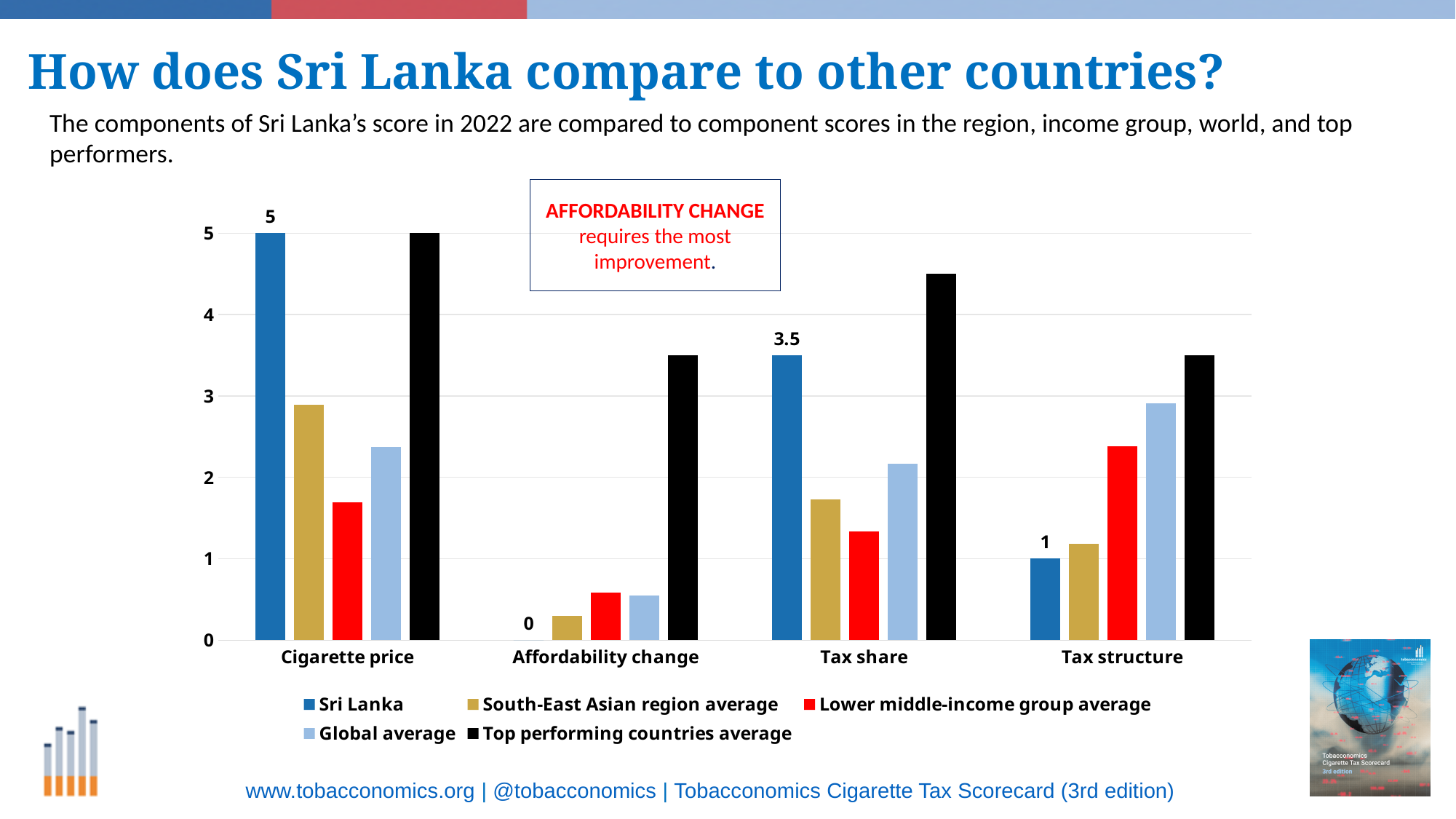
In which component does Sri Lanka have its highest score? Cigarette price How many series does the legend list? 5 What is the difference between Sri Lanka's Cigarette price score and its Tax share score? 1.5 What is Sri Lanka's score for Cigarette price? 5 Is the Global average for Tax structure greater or less than 2? greater For Tax structure, which is larger: the Sri Lanka score or the Lower middle-income group average? Lower middle-income group average In which component does Sri Lanka have its lowest score? Affordability change What is Sri Lanka's score for Tax structure? 1 What is Sri Lanka's score for Affordability change? 0 Is the Top performing countries average for Tax share greater or less than 4? greater What is Sri Lanka's score for Tax share? 3.5 What type of chart is shown on the slide? Bar chart